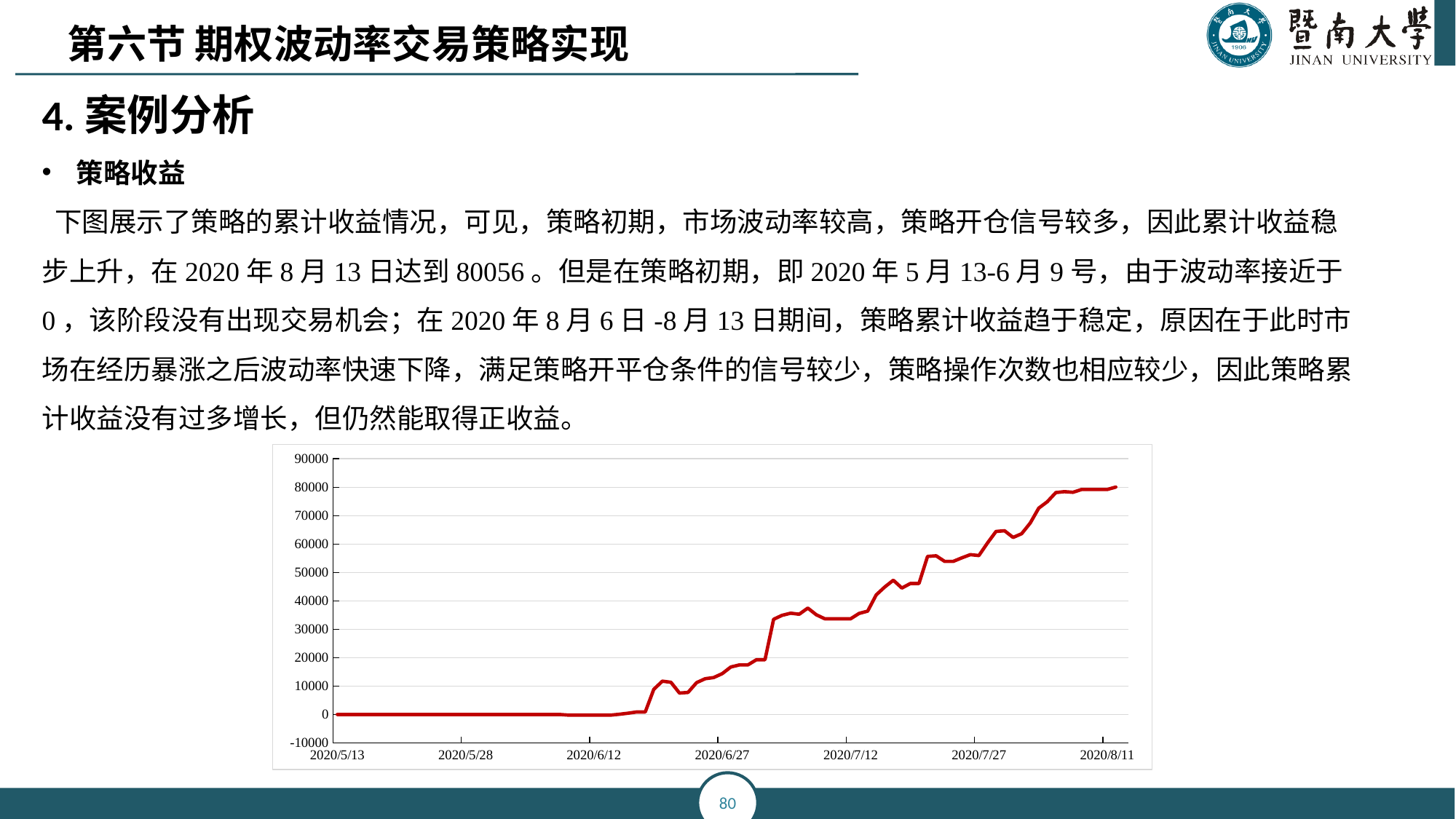
Is the value at 2020/5/28 greater or less than 10000? less What colour is the line in the chart? red How many date labels are shown on the x axis? 7 Is the value at 2020/6/12 greater or less than 10000? less Is the value at 2020/8/11 greater or less than 70000? greater What kind of chart is shown on the slide? line chart Do the values in the chart generally rise or fall from 2020/5/13 to 2020/8/11? rise Which is larger, the value at 2020/7/12 or the value at 2020/7/27? 2020/7/27 What is the highest value shown on the y axis? 90000